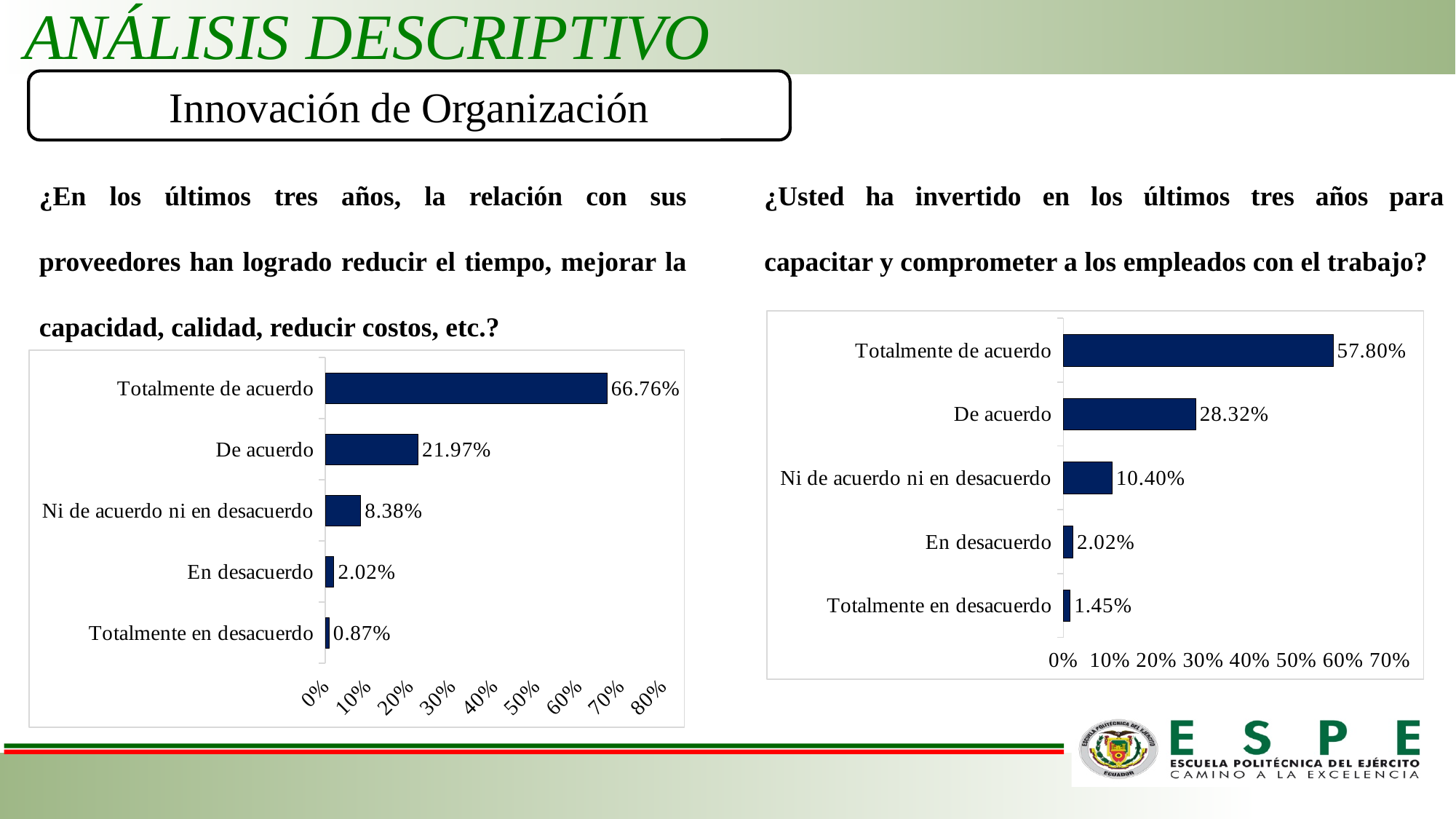
What kind of chart is the left chart (about the relationship with suppliers)? Bar chart In the left chart (about the relationship with suppliers), what is the value for "Ni de acuerdo ni en desacuerdo"? 8.38% In the right chart (about investing to train and engage employees), what is the value for "De acuerdo"? 28.32% In the right chart (about investing to train and engage employees), which is larger: "En desacuerdo" or "Totalmente en desacuerdo"? En desacuerdo What is the highest tick value shown on the x axis of the left chart (about the relationship with suppliers)? 80% In the left chart (about the relationship with suppliers), which category has the lowest value? Totalmente en desacuerdo In the left chart (about the relationship with suppliers), what is the value for "Totalmente de acuerdo"? 66.76% In the left chart (about the relationship with suppliers), what is the difference between "Totalmente de acuerdo" and "De acuerdo"? 44.79% How many categories does the right chart (about investing to train and engage employees) show? 5 In the right chart (about investing to train and engage employees), what is the difference between "Ni de acuerdo ni en desacuerdo" and "En desacuerdo"? 8.38% In the left chart (about the relationship with suppliers), is the value for "Totalmente de acuerdo" greater or less than 60%? greater In the right chart (about investing to train and engage employees), which category has the highest value? Totalmente de acuerdo